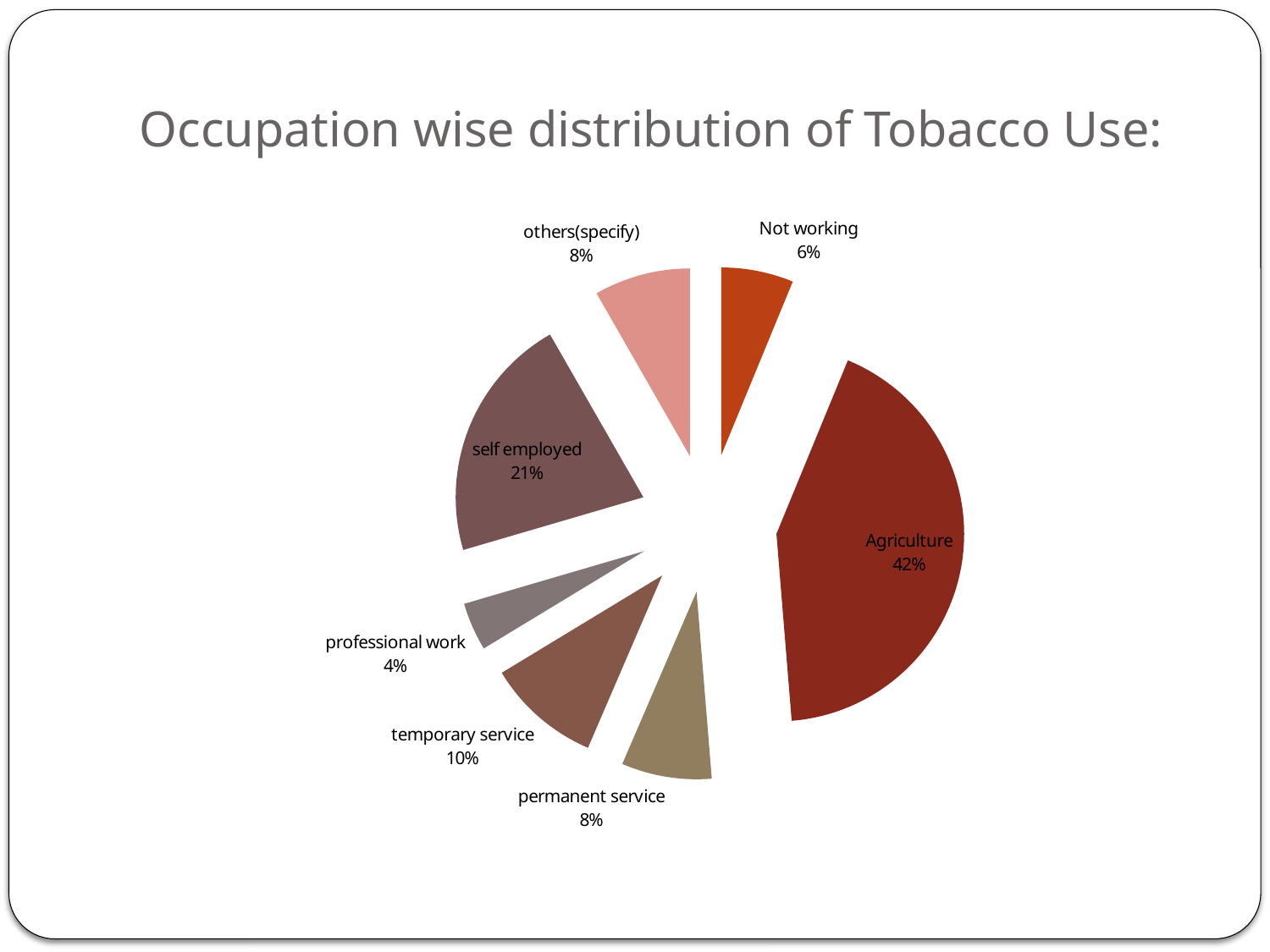
Which occupation category has the largest slice of the pie? Agriculture What percentage is shown for Not working? 6% What percentage is shown for self employed? 21% Which is larger, the share for temporary service or the share for permanent service? temporary service Which occupation category has the smallest slice of the pie? professional work What is the title of the chart on the slide? Occupation wise distribution of Tobacco Use: What percentage is shown for temporary service? 10% How many occupation categories are shown in the pie chart? 7 What share of tobacco use is attributed to Agriculture? 42% What is the difference in percentage points between Agriculture and self employed? 21 What kind of chart is shown on the slide? pie chart What percentage is shown for professional work? 4%